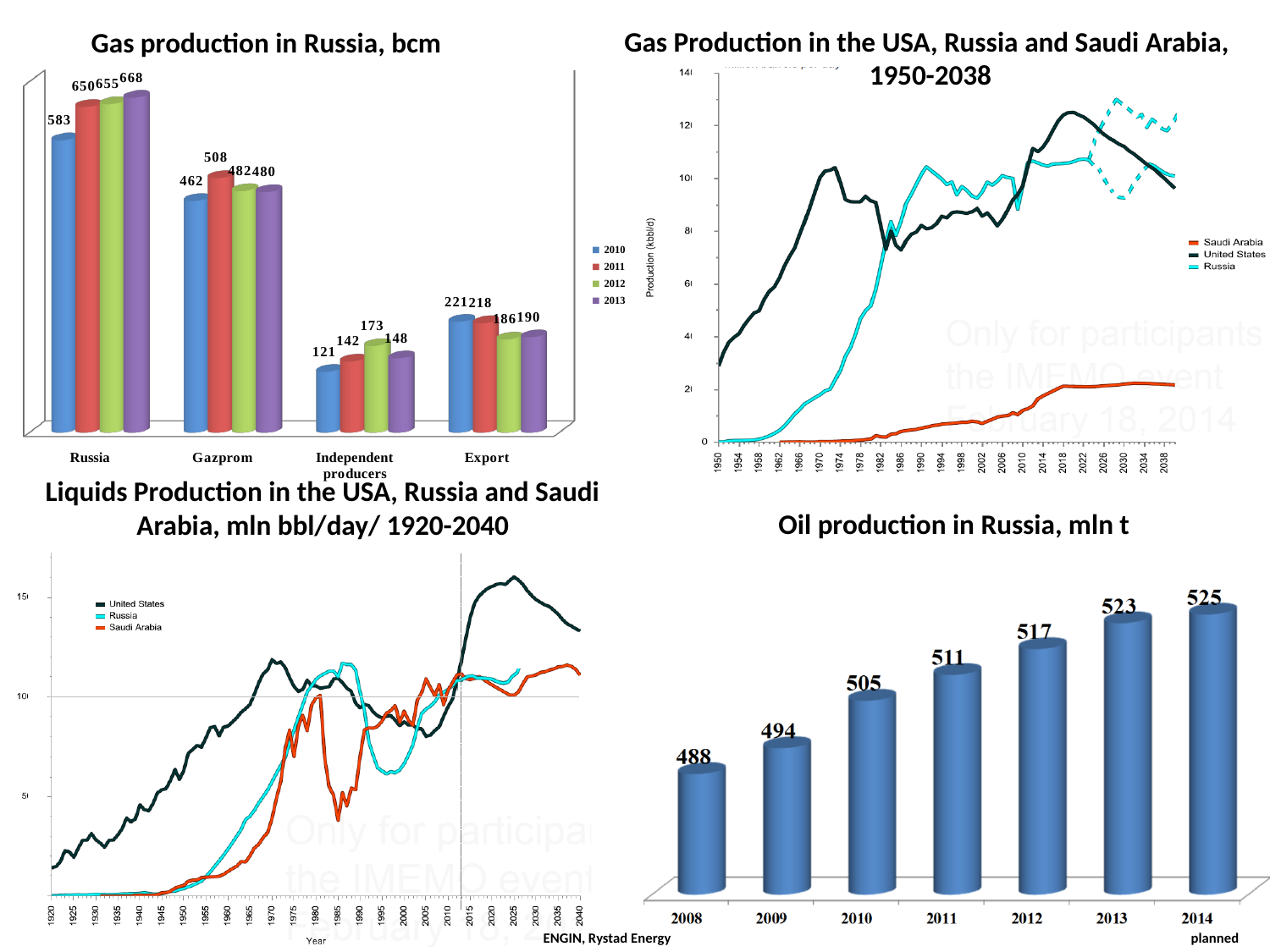
In the 'Oil production in Russia, mln t' chart, which year has the lowest value? 2008 In the 'Gas production in Russia, bcm' chart, what is the difference between the Russia values for 2013 and 2010? 85 In the 'Gas production in Russia, bcm' chart, how many series does the legend list? 4 In the 'Gas production in Russia, bcm' chart, what is the value for Export in 2012? 186 In the 'Gas production in Russia, bcm' chart, which year has the highest value for Independent producers? 2012 In the 'Oil production in Russia, mln t' chart, how many years are shown? 7 In the 'Oil production in Russia, mln t' chart, do the values rise or fall from 2008 to 2014? rise What kind of chart is 'Gas Production in the USA, Russia and Saudi Arabia, 1950-2038'? line chart In the 'Oil production in Russia, mln t' chart, what is the value for 2010? 505 In the 'Gas production in Russia, bcm' chart, what is the value for Gazprom in 2011? 508 In the 'Oil production in Russia, mln t' chart, what is the difference between the 2014 planned value and the 2008 value? 37 In the 'Liquids Production in the USA, Russia and Saudi Arabia' chart, how many series does the legend list? 3